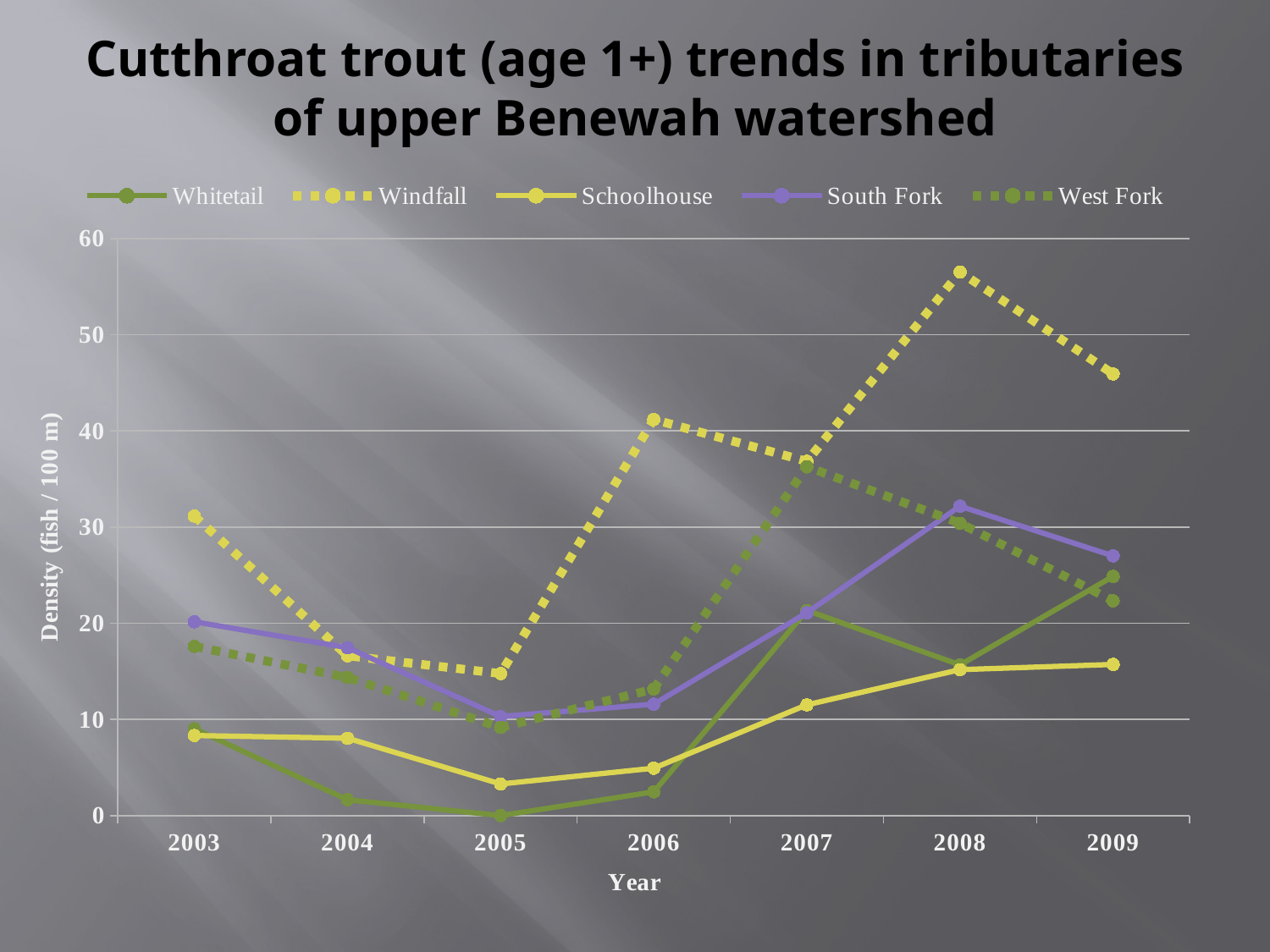
How many years are shown along the x axis? 7 Is the value for Windfall in 2008 greater or less than 50? greater In 2009, which is larger: the density for South Fork or for Schoolhouse? South Fork Does the Schoolhouse line rise or fall from 2005 to 2009? rises Is the value for Whitetail in 2005 greater or less than 10? less Which tributary has the highest density in 2008? Windfall In 2003, which is larger: the density for Windfall or for South Fork? Windfall Is the value for South Fork in 2008 greater or less than 30? greater Which tributary has the lowest density in 2005? Whitetail What is the label on the y axis? Density (fish / 100 m) What kind of chart is shown on the slide? line chart How many series does the legend list? 5